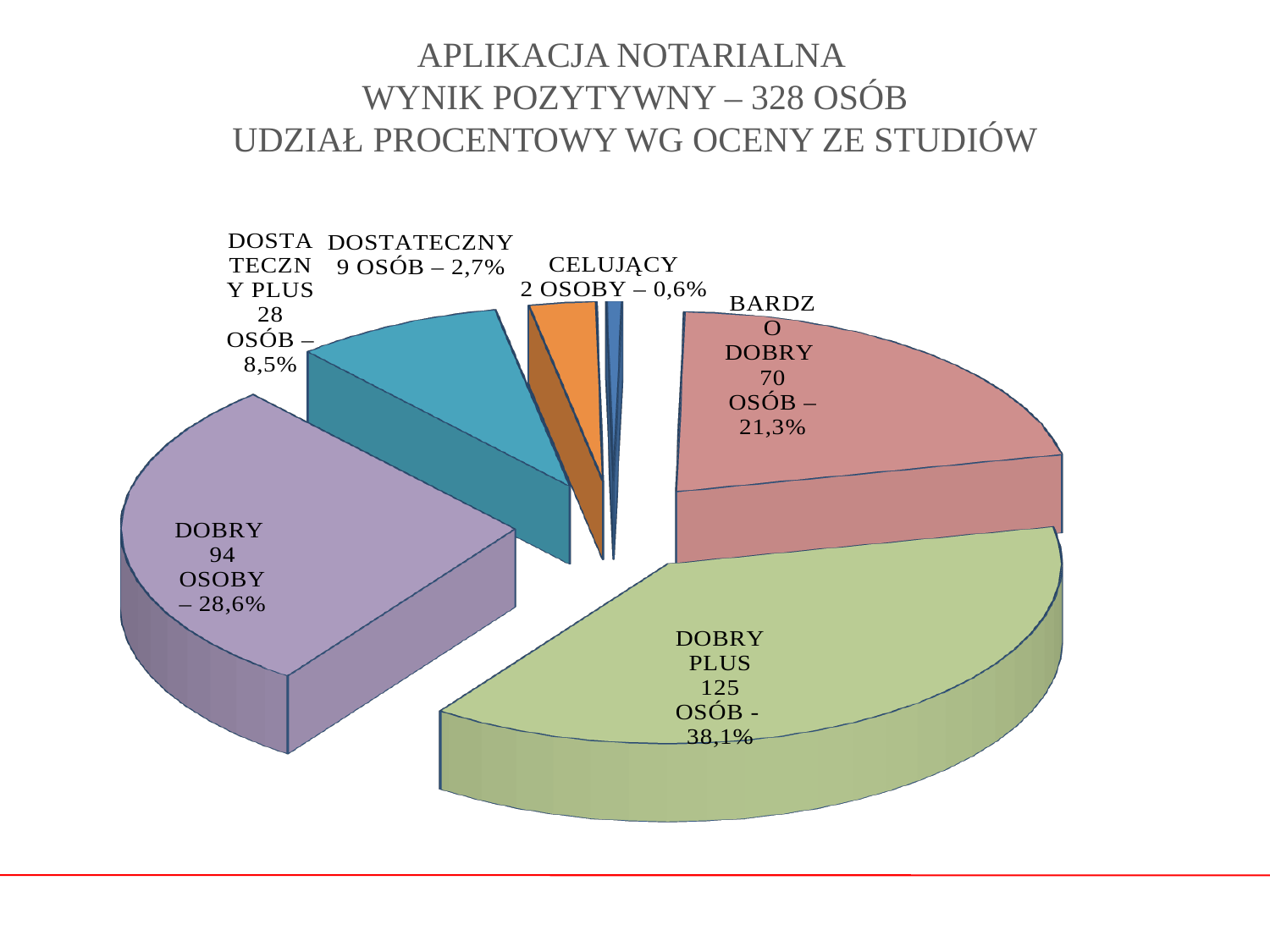
What percentage share does the DOBRY PLUS slice represent? 38,1% According to the chart title, how many people achieved a positive result? 328 Which category has the smallest slice of the pie? CELUJĄCY Which category has the largest slice of the pie? DOBRY PLUS How many people are in the DOSTATECZNY PLUS category? 28 What kind of chart is shown on the slide? pie chart What percentage share does the CELUJĄCY slice represent? 0,6% How many slices does the pie chart have? 6 What is the percentage share of the DOSTATECZNY slice? 2,7% How many people are in the BARDZO DOBRY category? 70 Which category has more people, BARDZO DOBRY or DOSTATECZNY PLUS? BARDZO DOBRY What is the difference in number of people between DOBRY PLUS and DOBRY? 31